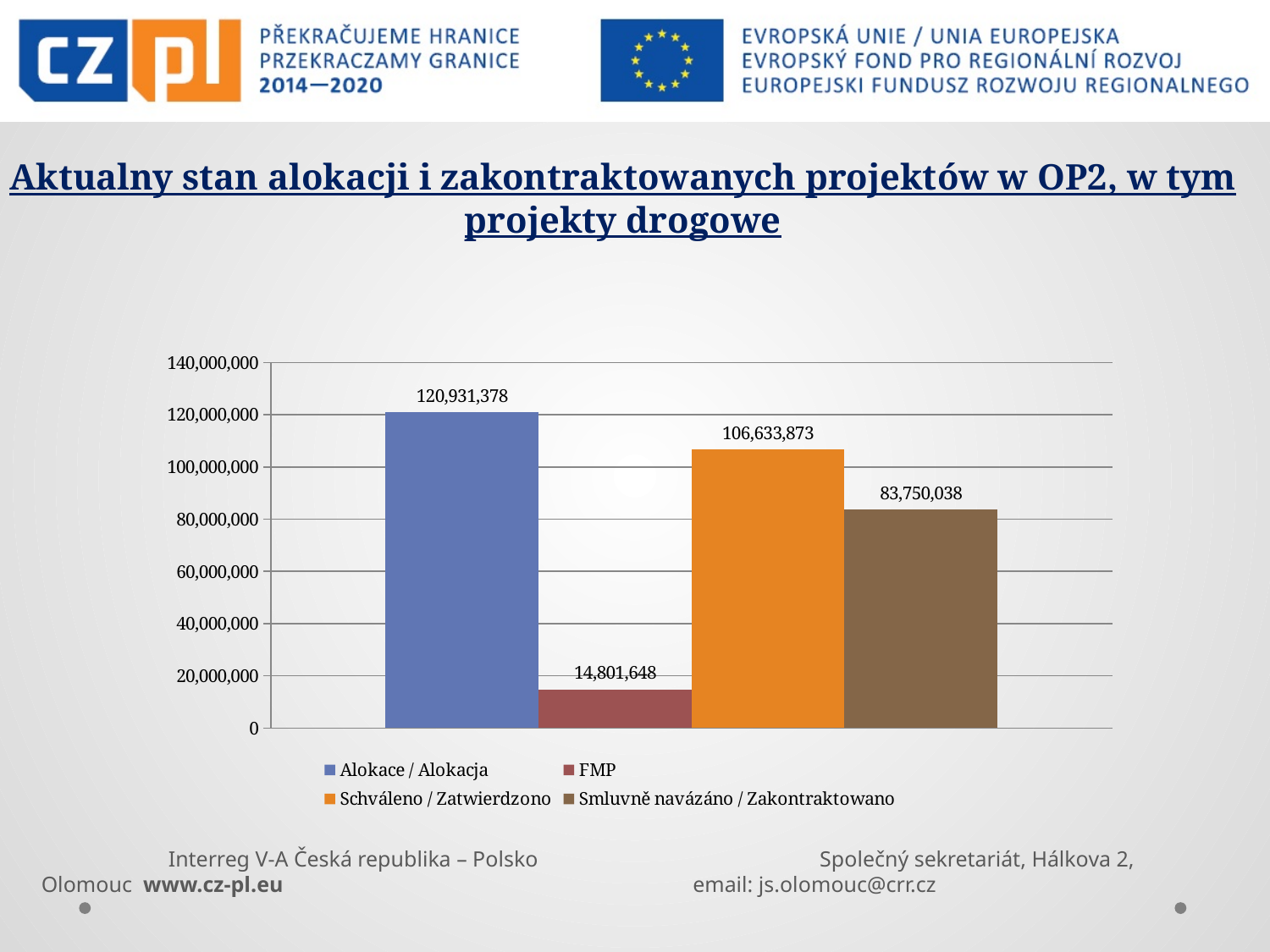
What is the value shown for FMP? 14,801,648 Which is larger, the Schváleno / Zatwierdzono value or the Smluvně navázáno / Zakontraktowano value? Schváleno / Zatwierdzono What is the value of the Schváleno / Zatwierdzono bar? 106,633,873 What kind of chart is shown on the slide? bar chart What is the value of the Alokace / Alokacja bar? 120,931,378 How many series does the legend list? 4 What is the difference between the Alokace / Alokacja value and the Schváleno / Zatwierdzono value? 14,297,505 Is the value for FMP greater or less than 20,000,000? less What is the value shown for Smluvně navázáno / Zakontraktowano? 83,750,038 Which series has the highest value in the chart? Alokace / Alokacja Which series has the lowest value in the chart? FMP What is the difference between the Schváleno / Zatwierdzono value and the Smluvně navázáno / Zakontraktowano value? 22,883,835